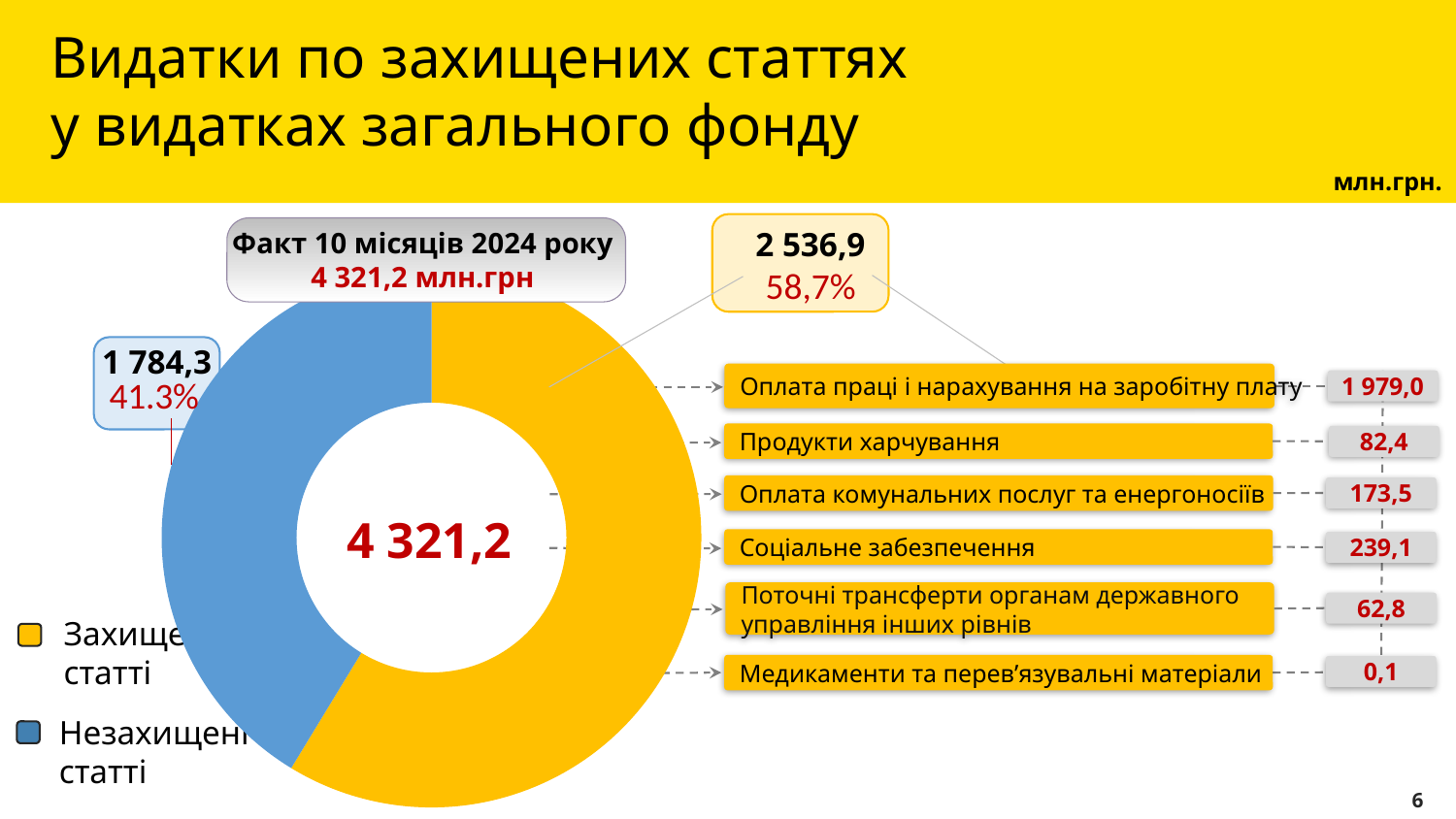
What value is shown for the yellow slice of the donut chart? 2 536,9 What kind of chart is shown on the slide? Donut (pie) chart What total value is printed in the centre of the donut chart? 4 321,2 What value is shown for the blue slice of the donut chart? 1 784,3 What unit of measurement is indicated in the top right corner of the slide? млн.грн. Which slice of the donut chart is larger, the yellow one or the blue one? The yellow one What percentage share does the yellow slice of the donut chart have? 58,7% What is the difference between the yellow slice value (2 536,9) and the blue slice value (1 784,3)? 752,6 In the breakdown to the right of the donut chart, what value is shown for 'Оплата праці і нарахування на заробітну плату'? 1 979,0 In the breakdown to the right of the donut chart, which item has the lowest value? Медикаменти та перев’язувальні матеріали What percentage share does the blue slice of the donut chart have? 41.3% How many slices does the donut chart have? 2